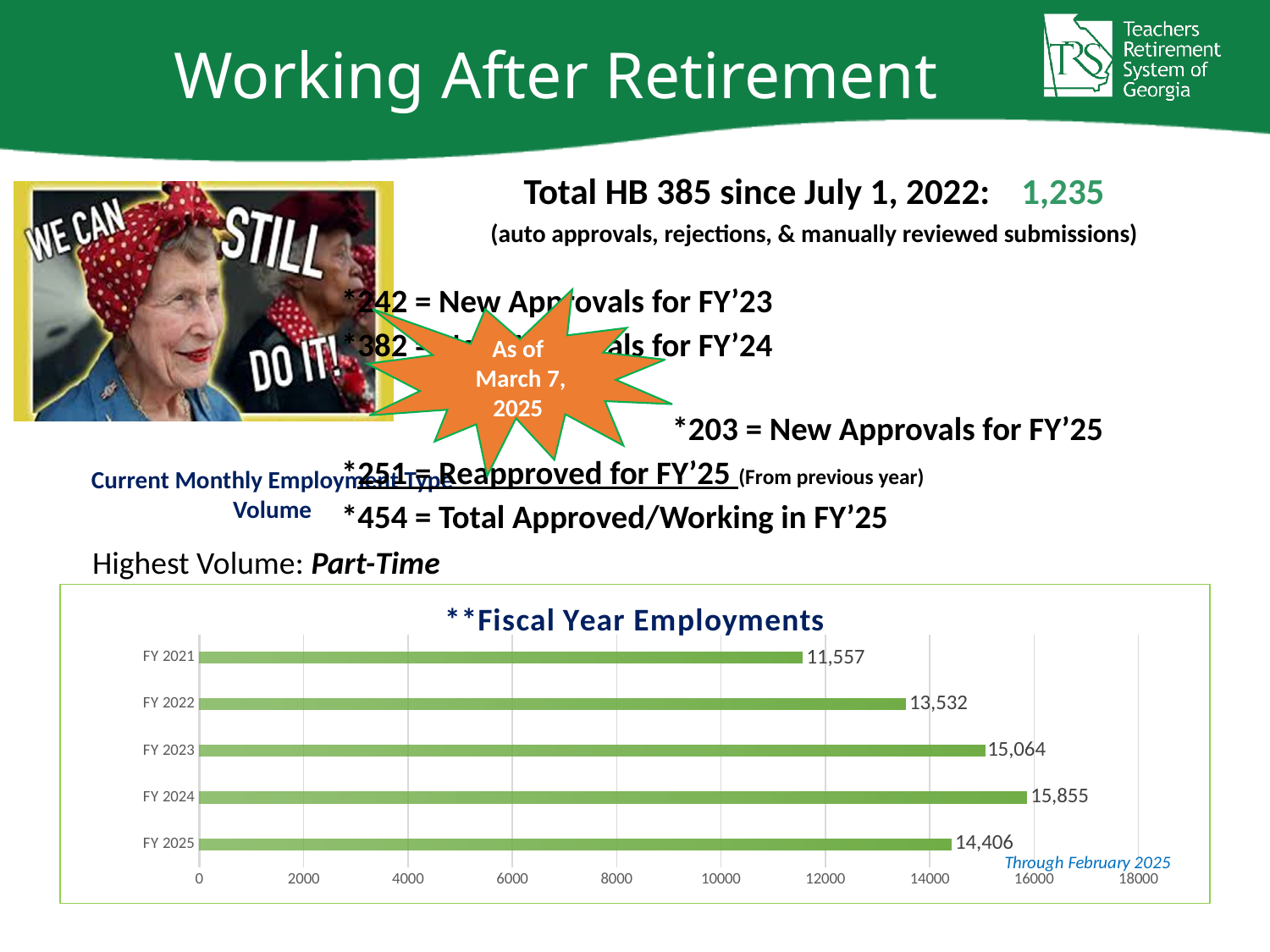
Which is larger in the Fiscal Year Employments chart, FY 2022 or FY 2025? FY 2025 What is the value for FY 2025 in the Fiscal Year Employments chart? 14,406 What is the title of the chart on the slide? **Fiscal Year Employments What is the difference between the FY 2024 and FY 2025 values in the Fiscal Year Employments chart? 1,449 Which fiscal year has the lowest value in the Fiscal Year Employments chart? FY 2021 What kind of chart is the Fiscal Year Employments chart? bar chart What is the value for FY 2023 in the Fiscal Year Employments chart? 15,064 How many fiscal years are shown in the Fiscal Year Employments chart? 5 What is the difference between the FY 2022 and FY 2021 values in the Fiscal Year Employments chart? 1,975 What is the value for FY 2021 in the Fiscal Year Employments chart? 11,557 Which fiscal year has the highest value in the Fiscal Year Employments chart? FY 2024 Is the value for FY 2023 in the Fiscal Year Employments chart greater or less than 14000? greater